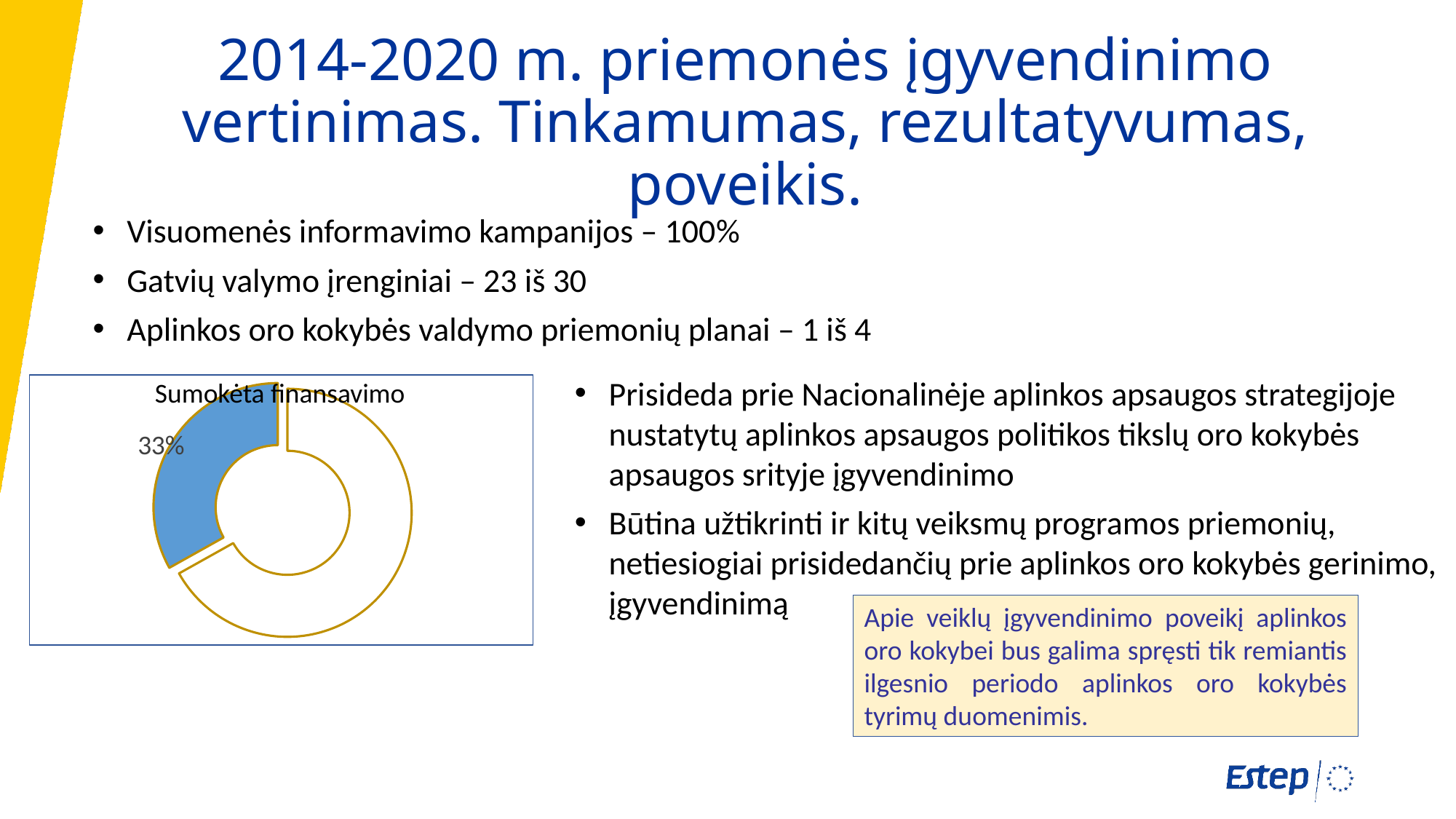
What is the only data label printed on the doughnut chart? 33% Which slice of the doughnut chart is larger, the blue slice or the white slice? the white slice How many slices does the doughnut chart have? 2 Is the blue slice of the doughnut chart greater or less than 50%? less What kind of chart is shown on the slide? doughnut chart What colour is the slice labelled 33% in the doughnut chart? blue What share of the doughnut chart does the blue slice represent? 33% Is the unlabeled white slice of the doughnut chart greater or less than 50%? greater What is the title of the chart on the slide? Sumokėta finansavimo